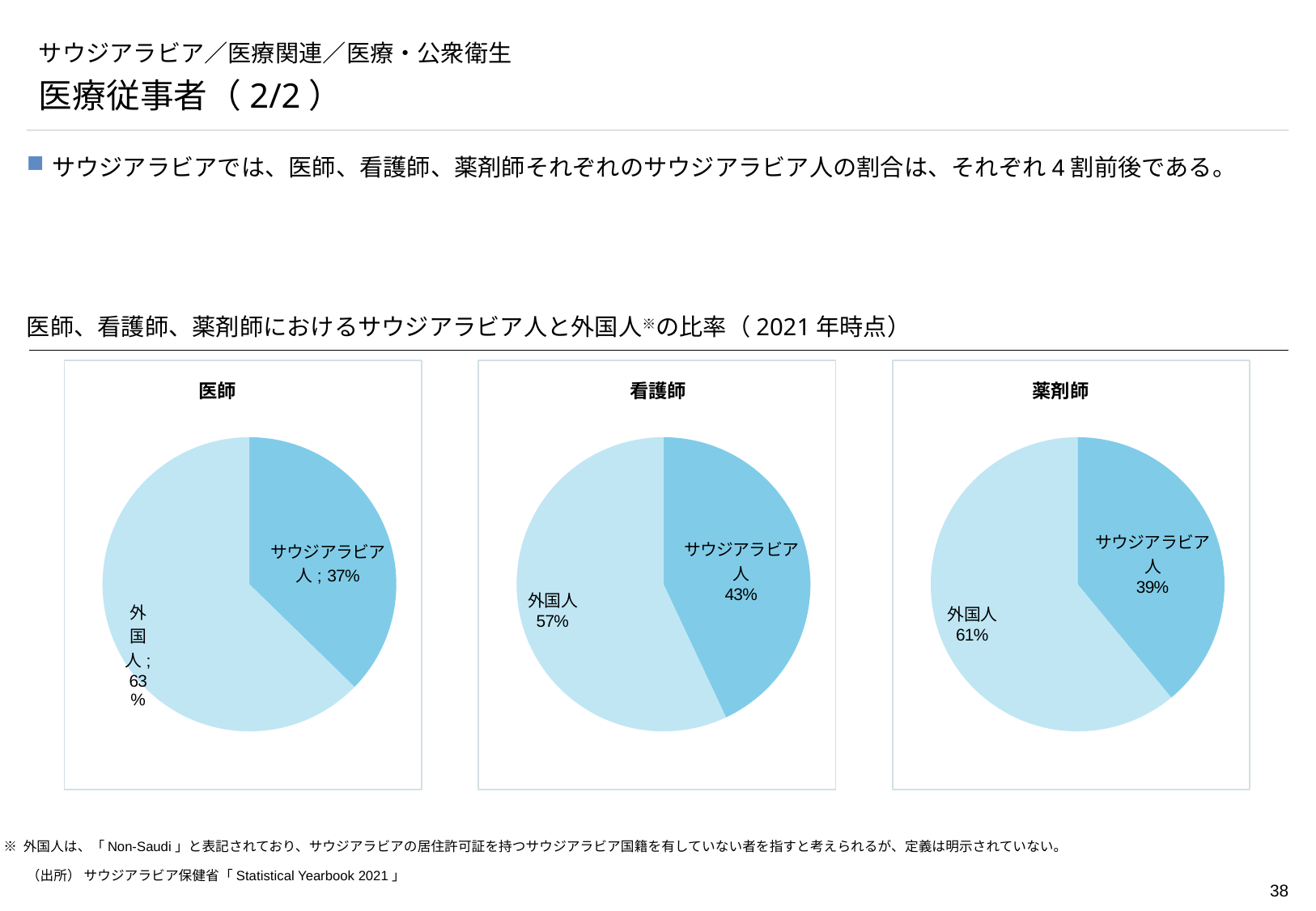
Across the three pie charts, which profession has the lowest サウジアラビア人 share? 医師 In the 医師 pie chart, what share is labelled for 外国人? 63% In the 薬剤師 pie chart, what share is labelled for サウジアラビア人? 39% How many slices does the 医師 pie chart have? 2 In the 医師 pie chart, what is the difference between the 外国人 share and the サウジアラビア人 share? 26% In the 医師 pie chart, what share is labelled for サウジアラビア人? 37% In the 看護師 pie chart, what share is labelled for サウジアラビア人? 43% Across the three pie charts, which profession has the highest サウジアラビア人 share? 看護師 In the 看護師 pie chart, what share is labelled for 外国人? 57% What kind of chart is used for 薬剤師? Pie chart In the 薬剤師 pie chart, what share is labelled for 外国人? 61% In the 看護師 pie chart, which slice is larger, サウジアラビア人 or 外国人? 外国人